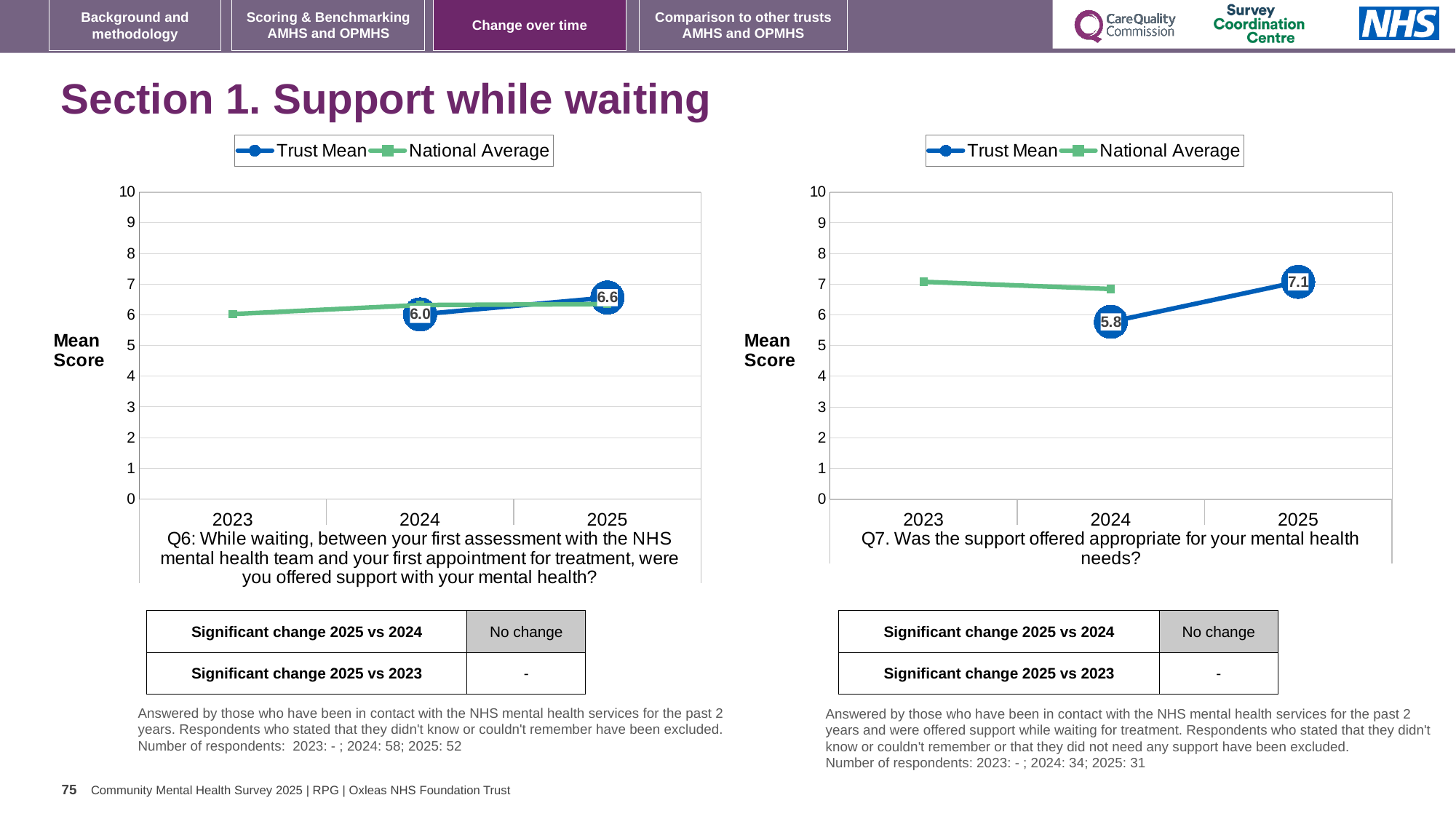
In the right chart (Q7), is the National Average for 2023 greater or less than 6? greater What kind of chart is the right chart (Q7)? line chart In the left chart (Q6), by how much did the Trust Mean change from 2024 to 2025? 0.6 In the left chart (Q6), what is the Trust Mean score for 2025? 6.6 In the right chart (Q7), by how much did the Trust Mean change from 2024 to 2025? 1.3 In the right chart (Q7), what is the Trust Mean score for 2024? 5.8 In the left chart (Q6), what is the Trust Mean score for 2024? 6.0 In the right chart (Q7), which is larger in 2024, the Trust Mean or the National Average? National Average In the right chart (Q7), what is the Trust Mean score for 2025? 7.1 In the left chart (Q6), is the Trust Mean for 2025 greater or less than 6? greater How many series does the legend of the left chart (Q6) list? 2 In the right chart (Q7), does the Trust Mean rise or fall from 2024 to 2025? rise